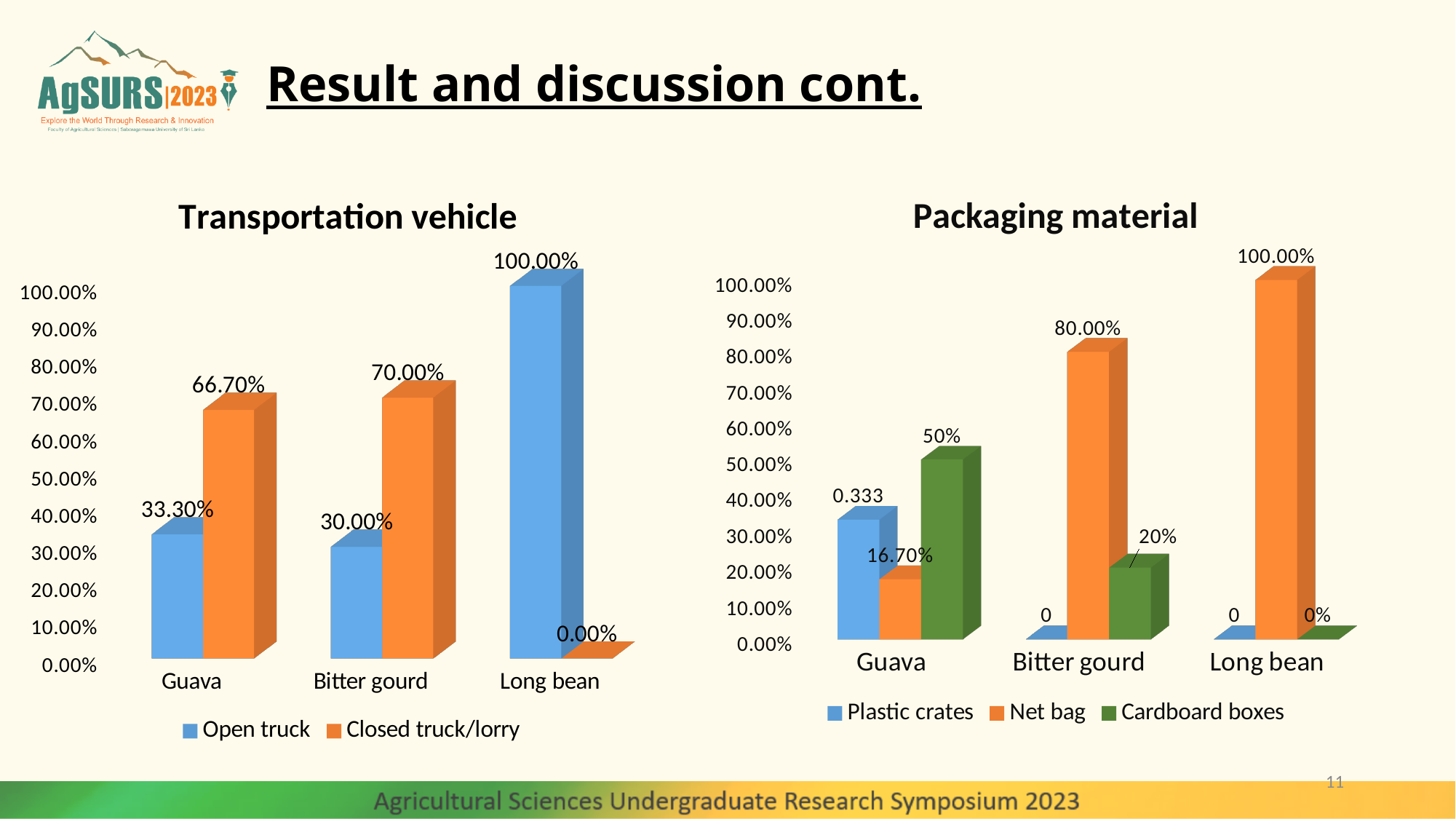
In the Transportation vehicle chart, what is the value for Closed truck/lorry for Bitter gourd? 70.00% In the Transportation vehicle chart, what is the value for Closed truck/lorry for Long bean? 0.00% In the Transportation vehicle chart, what is the difference between the Closed truck/lorry and Open truck values for Guava? 33.40% In the Transportation vehicle chart, what is the value for Open truck for Guava? 33.30% What kind of chart is the Packaging material chart? bar chart In the Transportation vehicle chart, which category has the highest Open truck value? Long bean In the Transportation vehicle chart, how many series does the legend list? 2 In the Packaging material chart, which category has the highest Net bag value? Long bean In the Packaging material chart, what is the value for Net bag for Bitter gourd? 80.00% In the Packaging material chart, what is the value for Cardboard boxes for Guava? 50% In the Packaging material chart, is the Cardboard boxes value for Bitter gourd larger or smaller than the Cardboard boxes value for Guava? smaller In the Packaging material chart, what is the value for Net bag for Guava? 16.70%